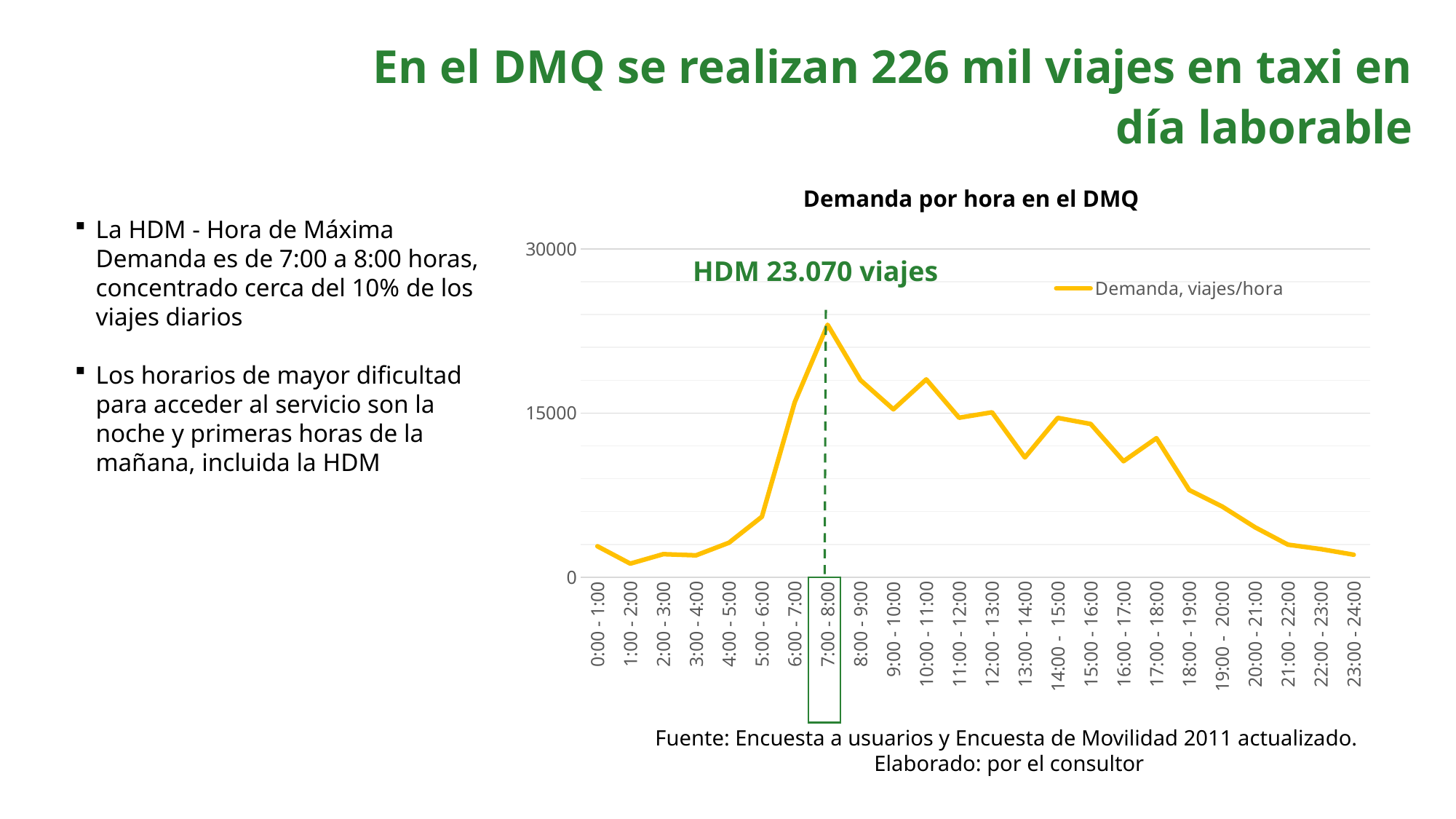
Do the values rise or fall from 18:00 - 19:00 to 23:00 - 24:00? Fall What kind of chart is shown on the slide? Line chart According to the annotation on the chart, how many viajes are there in the HDM (7:00 - 8:00)? 23.070 What is the name of the series shown in the chart legend? Demanda, viajes/hora How many hourly categories are shown on the x axis of the chart? 24 Which hour interval has the highest demand in the chart? 7:00 - 8:00 Which hour interval has the lowest demand in the chart? 1:00 - 2:00 Which has a higher demand, 6:00 - 7:00 or 5:00 - 6:00? 6:00 - 7:00 What is the title of the chart? Demanda por hora en el DMQ Is the value for 10:00 - 11:00 greater or less than 15000? greater Is the value for 13:00 - 14:00 greater or less than 15000? less How many series does the chart legend list? 1